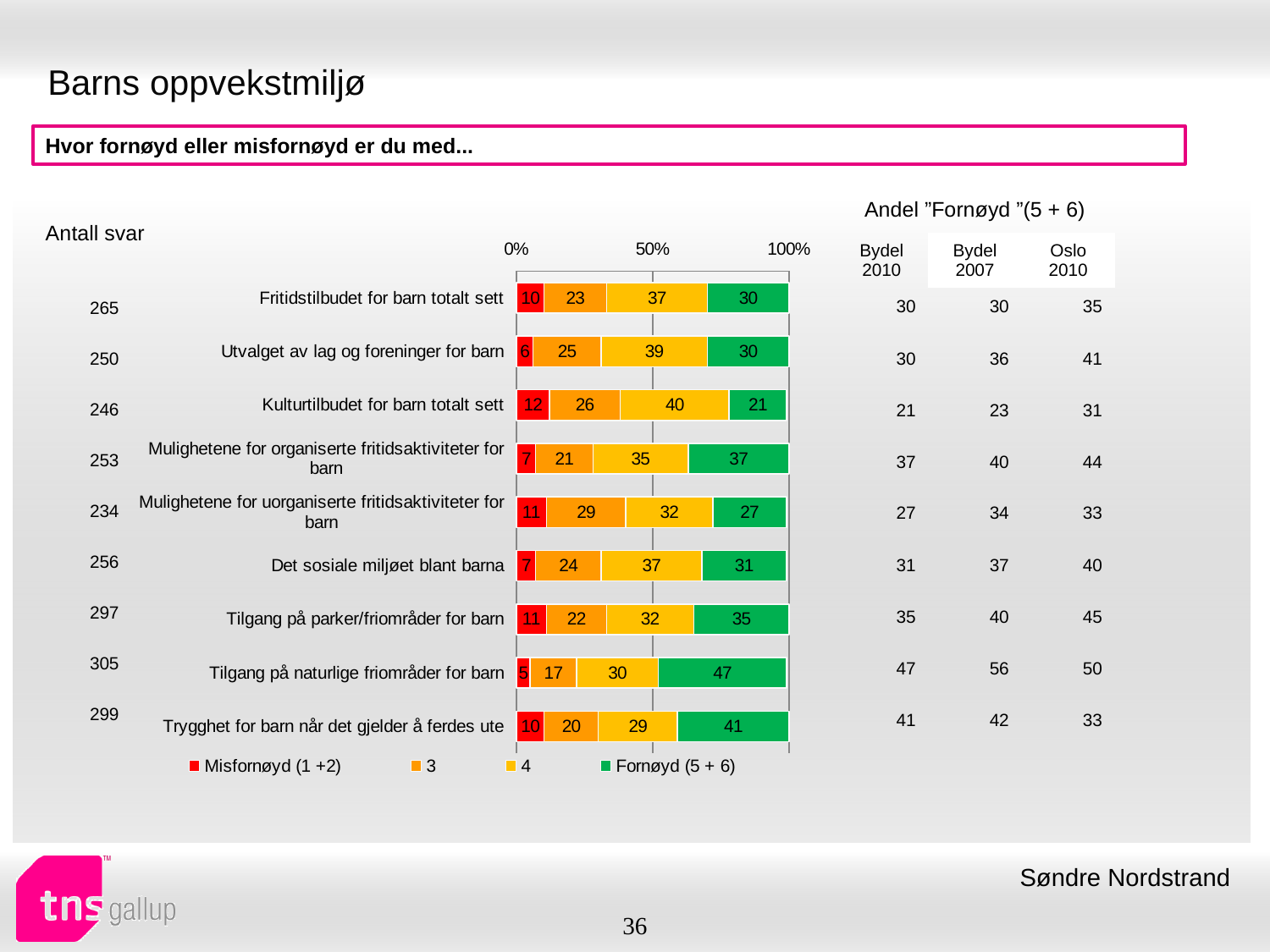
What is the total of the stacked bar for 'Kulturtilbudet for barn totalt sett'? 99 Which is larger: the 'Fornøyd (5 + 6)' value for 'Tilgang på parker/friområder for barn' or for 'Mulighetene for uorganiserte fritidsaktiviteter for barn'? Tilgang på parker/friområder for barn Which category has the lowest 'Fornøyd (5 + 6)' value? Kulturtilbudet for barn totalt sett What is the value of series '4' for 'Utvalget av lag og foreninger for barn'? 39 What is the 'Fornøyd (5 + 6)' value for 'Tilgang på naturlige friområder for barn'? 47 Which colour represents 'Fornøyd (5 + 6)' in the chart? Green What is the difference between the 'Fornøyd (5 + 6)' values for 'Trygghet for barn når det gjelder å ferdes ute' and 'Det sosiale miljøet blant barna'? 10 What kind of chart is shown on the slide? Stacked bar chart How many series does the legend list? 4 What is the 'Misfornøyd (1 +2)' value for 'Kulturtilbudet for barn totalt sett'? 12 Which category has the highest 'Fornøyd (5 + 6)' value? Tilgang på naturlige friområder for barn How many categories are plotted in the chart? 9